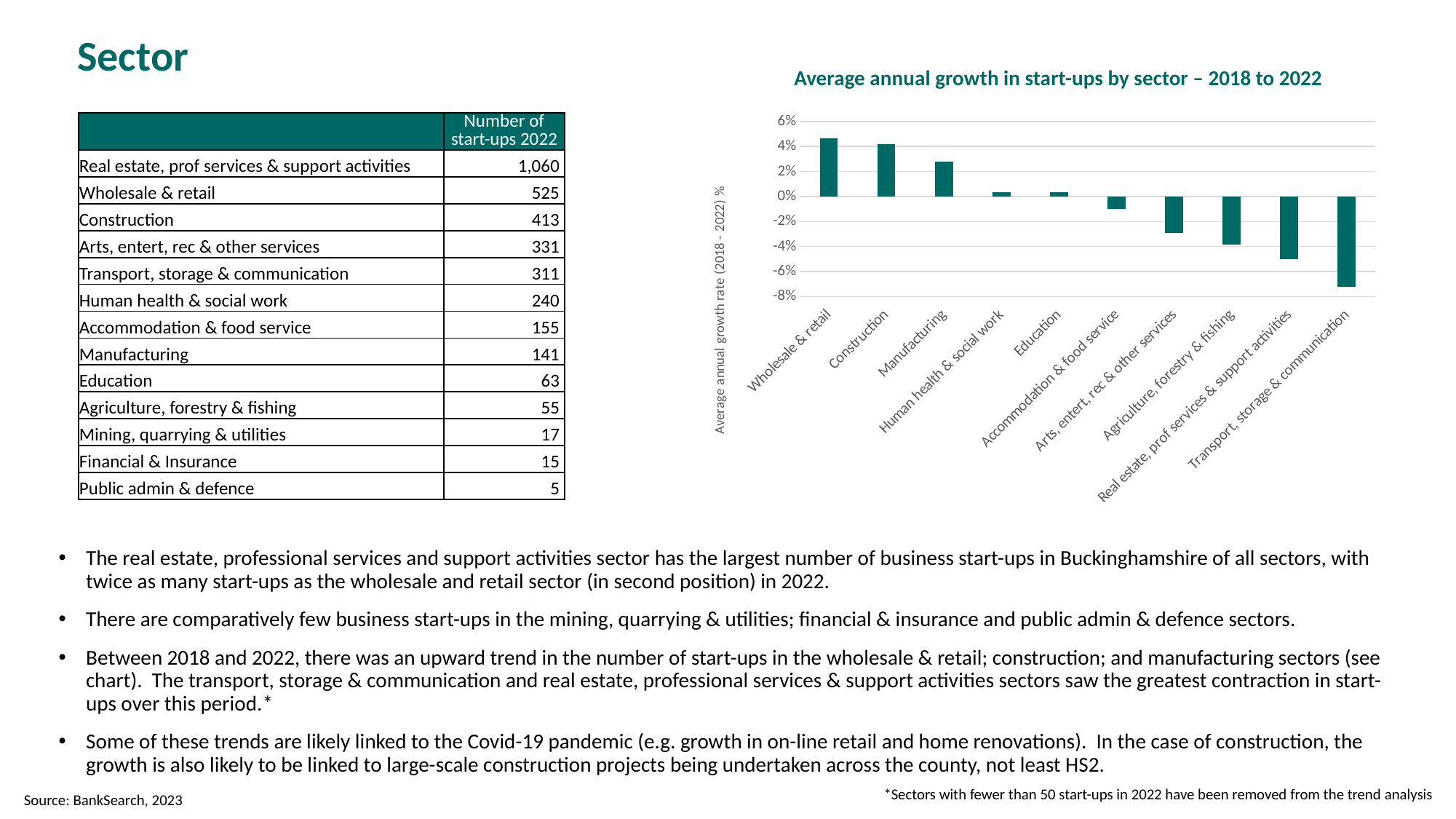
Is the value for Agriculture, forestry & fishing greater or less than -2%? less Is the value for Transport, storage & communication greater or less than -6%? less How many sectors are plotted in the chart? 10 Is the value for Manufacturing greater or less than 2%? greater What kind of chart is shown on the slide? bar chart Do the bar values rise or fall moving from left to right along the x axis? fall Which has the higher average annual growth rate, Wholesale & retail or Manufacturing? Wholesale & retail Which sector has the highest average annual growth rate in the chart? Wholesale & retail What is the title of the chart? Average annual growth in start-ups by sector – 2018 to 2022 Which has the lower average annual growth rate, Accommodation & food service or Real estate, prof services & support activities? Real estate, prof services & support activities Which sector has the lowest average annual growth rate in the chart? Transport, storage & communication